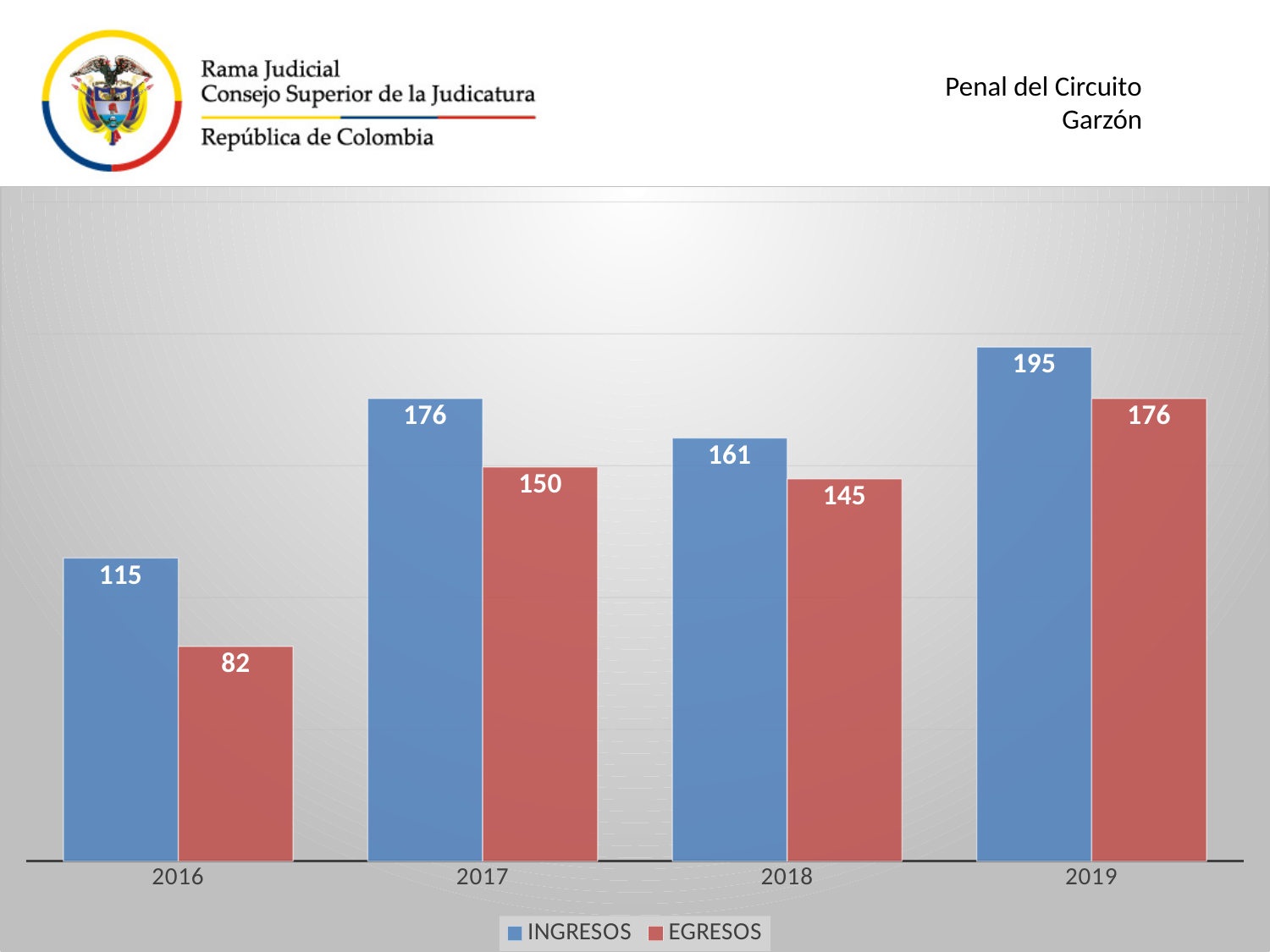
Which is larger, EGRESOS in 2017 or EGRESOS in 2018? EGRESOS in 2017 What is the difference between INGRESOS in 2017 and INGRESOS in 2018? 15 Which year has the highest INGRESOS value? 2019 What is the EGRESOS value for 2018? 145 Which year has the lowest EGRESOS value? 2016 What kind of chart is shown on the slide? Bar chart What is the EGRESOS value for 2019? 176 How many series does the legend list? 2 What is the difference between INGRESOS and EGRESOS in 2016? 33 Which series is shown in red in the legend? EGRESOS How many years are shown on the x axis? 4 What is the INGRESOS value for 2016? 115